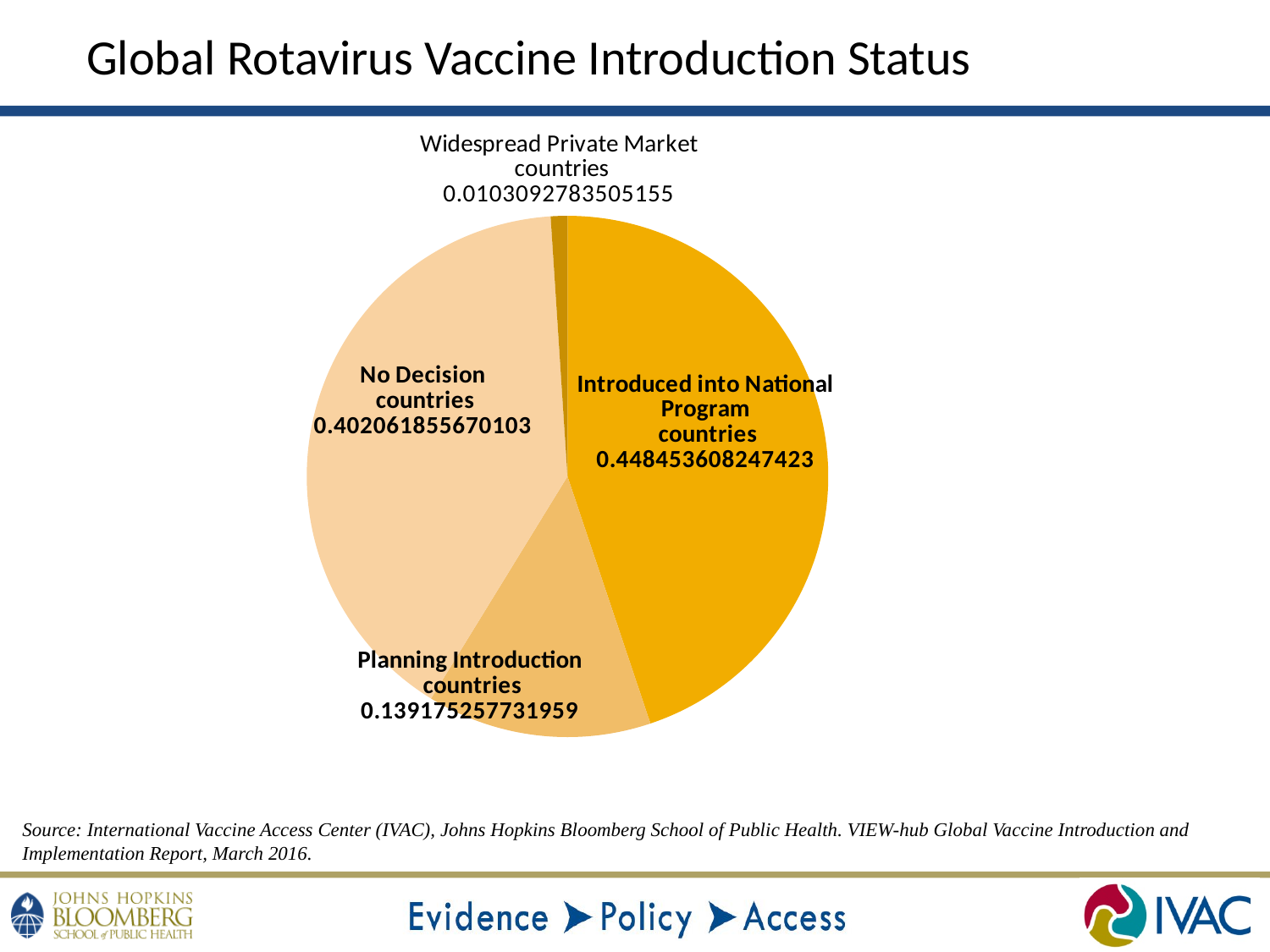
Which is larger, the value for No Decision countries or the value for Planning Introduction countries? No Decision countries What value is shown for Widespread Private Market countries? 0.0103092783505155 What value is shown for No Decision countries? 0.402061855670103 What value is shown for Planning Introduction countries? 0.139175257731959 How many slices does the pie chart have? 4 What share of the pie does the No Decision countries slice represent, as printed on the chart? 0.402061855670103 Which is larger, the value for Planning Introduction countries or the value for Widespread Private Market countries? Planning Introduction countries Which category has the largest slice of the pie? Introduced into National Program countries What value is shown for Introduced into National Program countries? 0.448453608247423 What kind of chart is shown on the slide? Pie chart Which category has the smallest slice of the pie? Widespread Private Market countries What is the title of the chart on the slide? Global Rotavirus Vaccine Introduction Status